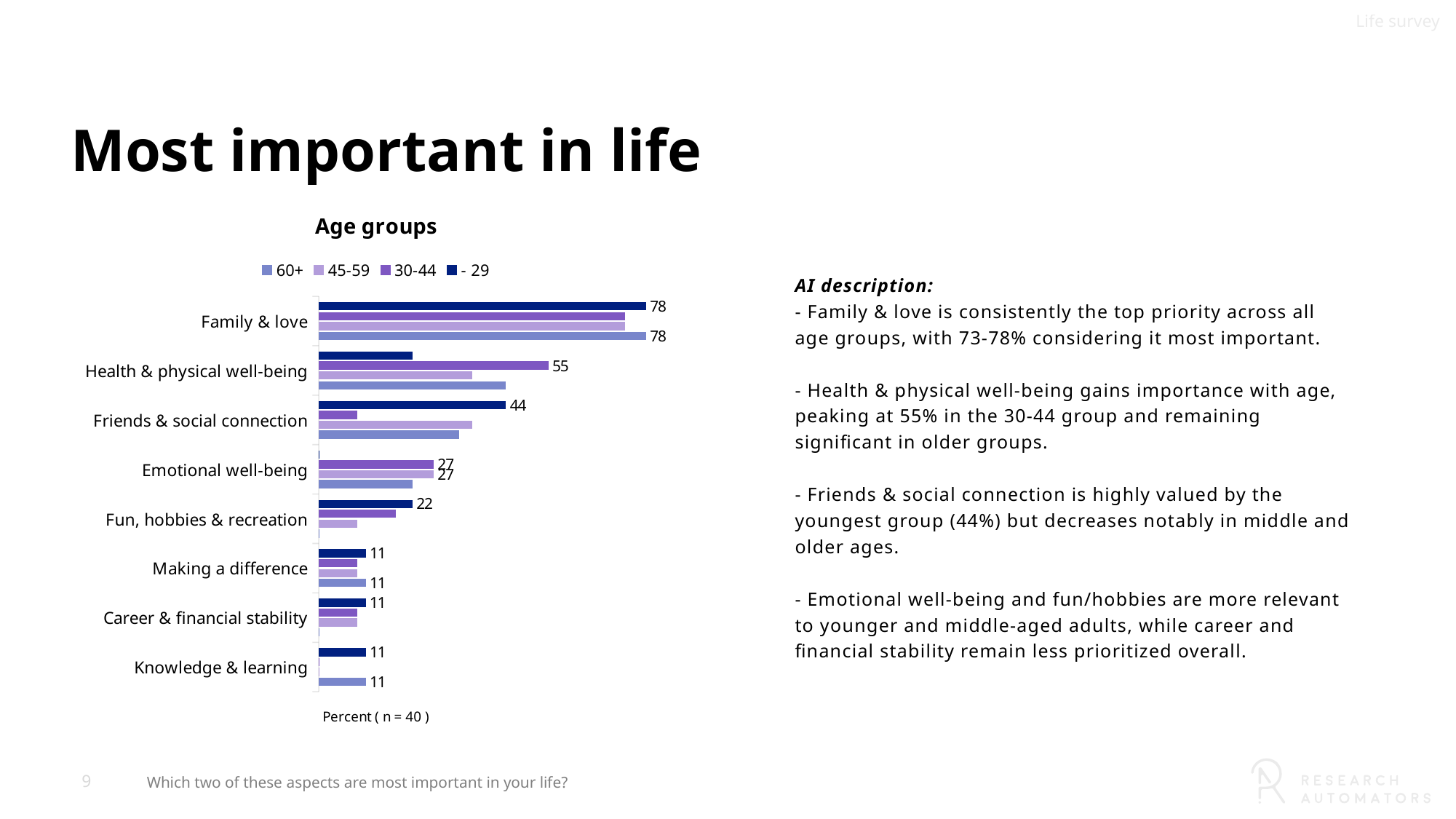
How many categories are plotted on the chart? 8 What is the value for Health & physical well-being in the 30-44 age group? 55 What is the value for Friends & social connection in the - 29 age group? 44 What is the value for Fun, hobbies & recreation in the - 29 age group? 22 What kind of chart is shown on the slide? bar chart How many series does the legend of the chart list? 4 What is the value for Emotional well-being in the 45-59 age group? 27 Which is larger: the 30-44 value for Health & physical well-being or the - 29 value for Friends & social connection? Health & physical well-being (30-44) Which category has the highest value for the - 29 age group? Family & love What are the legend entries of the chart? 60+, 45-59, 30-44, - 29 What is the value for Family & love in the - 29 age group? 78 What is the difference between the - 29 values for Family & love and Friends & social connection? 34